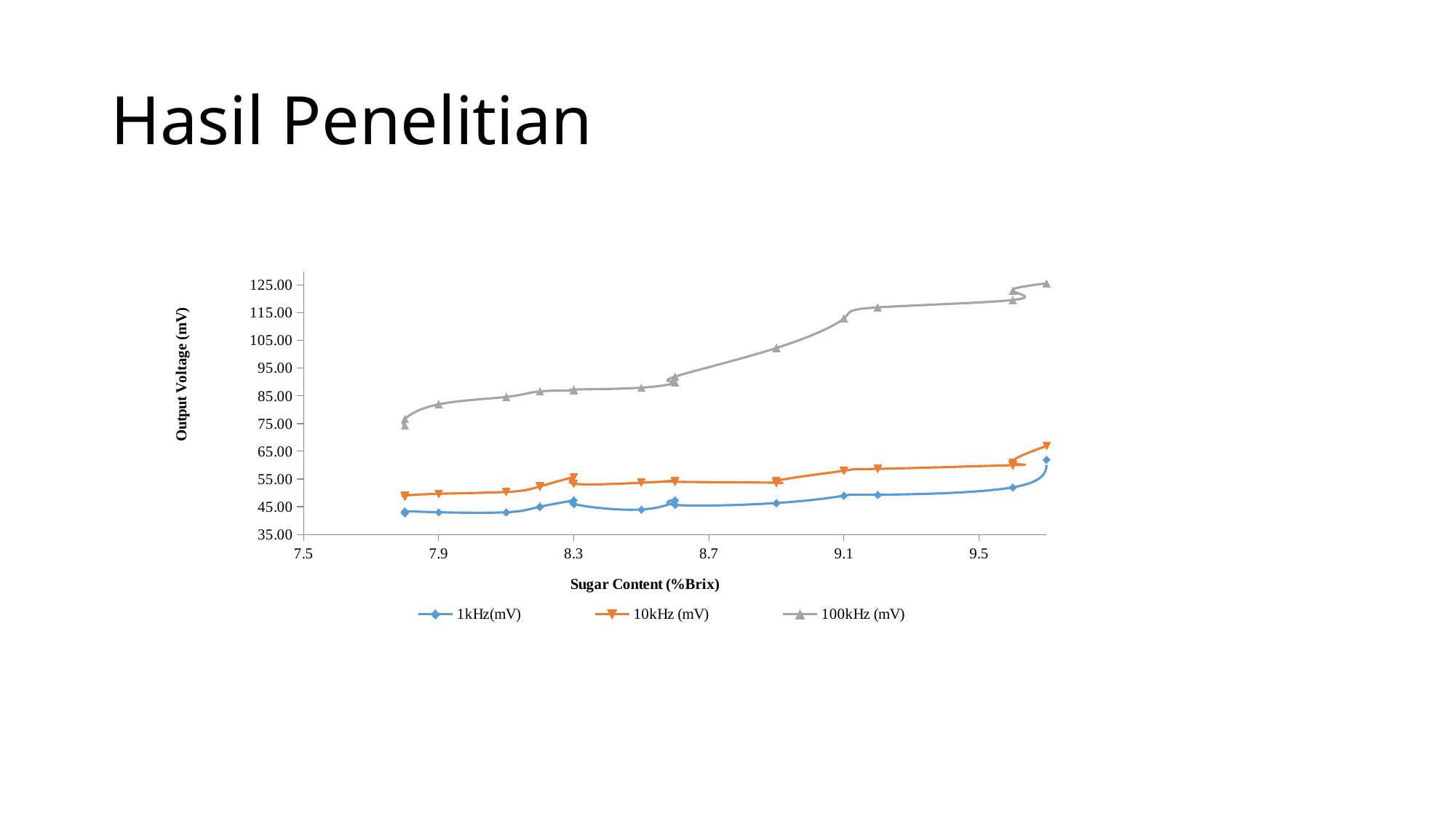
Which series has the highest output voltage across the sugar content range? 100kHz (mV) Which series has the lowest output voltage across the sugar content range? 1kHz(mV) Is the value of the 100kHz (mV) series at 9.1 %Brix greater or less than 105.00? greater How many series does the legend list? 3 Is the value of the 100kHz (mV) series at 7.9 %Brix greater or less than 75.00? greater Is the value of the 10kHz (mV) series at 9.1 %Brix greater or less than 65.00? less What is the label of the x axis? Sugar Content (%Brix) What kind of chart is shown on the slide? line chart What is the label of the y axis? Output Voltage (mV) At 8.7 %Brix, which series has the larger value: 10kHz (mV) or 100kHz (mV)? 100kHz (mV) Do the values of the 100kHz (mV) series rise or fall as sugar content increases? rise